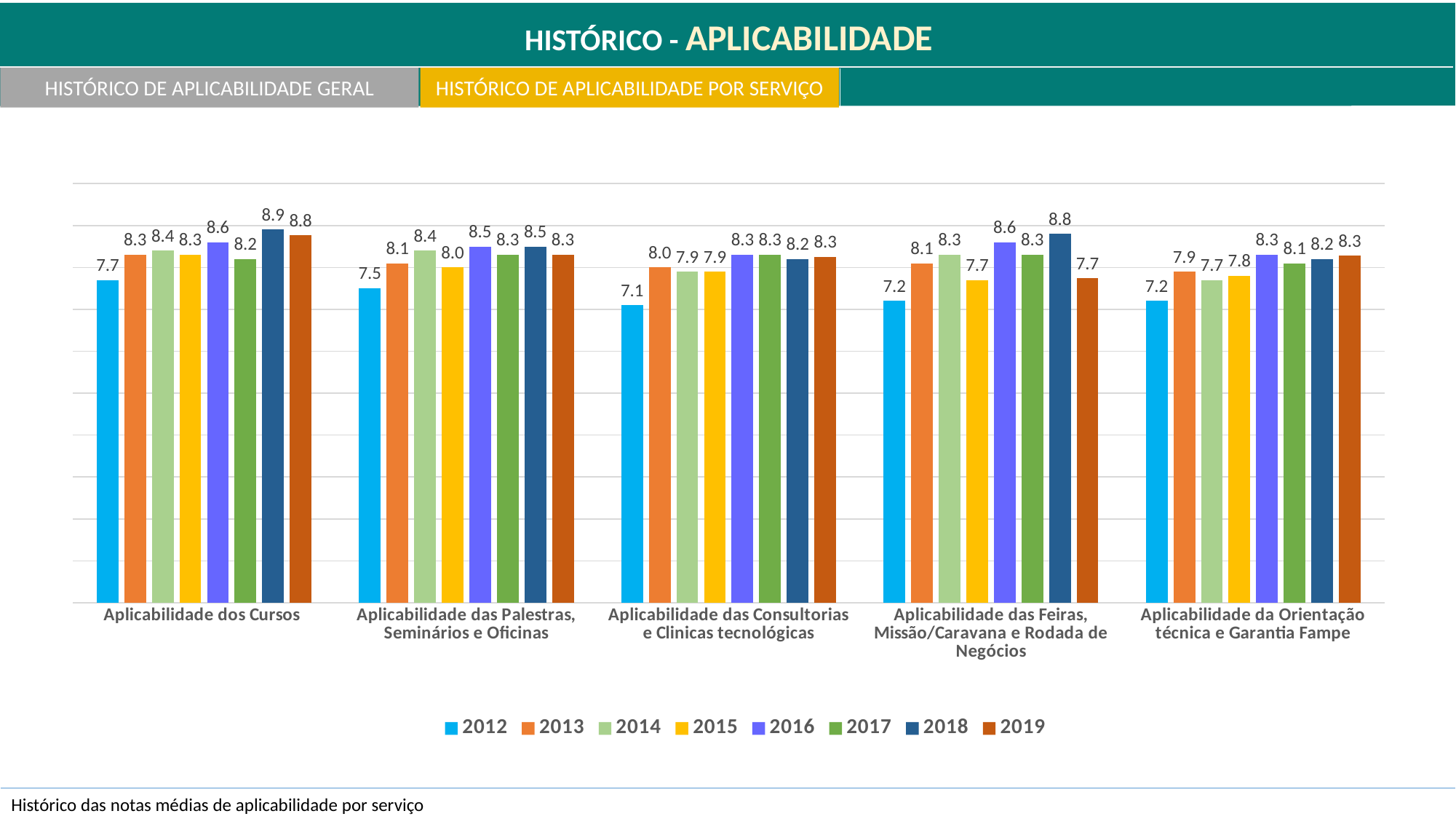
Which category has the lowest 2012 value? Aplicabilidade das Consultorias e Clinicas tecnológicas How many series does the legend list? 8 What is the first year listed in the legend? 2012 What is the value for 2019 in the 'Aplicabilidade das Feiras, Missão/Caravana e Rodada de Negócios' category? 7.7 How many service categories are shown on the x axis? 5 Which year has the highest value in the 'Aplicabilidade das Feiras, Missão/Caravana e Rodada de Negócios' category? 2018 Which year has the lowest value in the 'Aplicabilidade das Palestras, Seminários e Oficinas' category? 2012 Which is larger in the 'Aplicabilidade da Orientação técnica e Garantia Fampe' category: the 2013 value or the 2016 value? 2016 What is the value for 2018 in the 'Aplicabilidade dos Cursos' category? 8.9 What is the value for 2012 in the 'Aplicabilidade das Consultorias e Clinicas tecnológicas' category? 7.1 What kind of chart is shown on the slide? bar chart What is the difference between the 2018 and 2012 values in the 'Aplicabilidade dos Cursos' category? 1.2